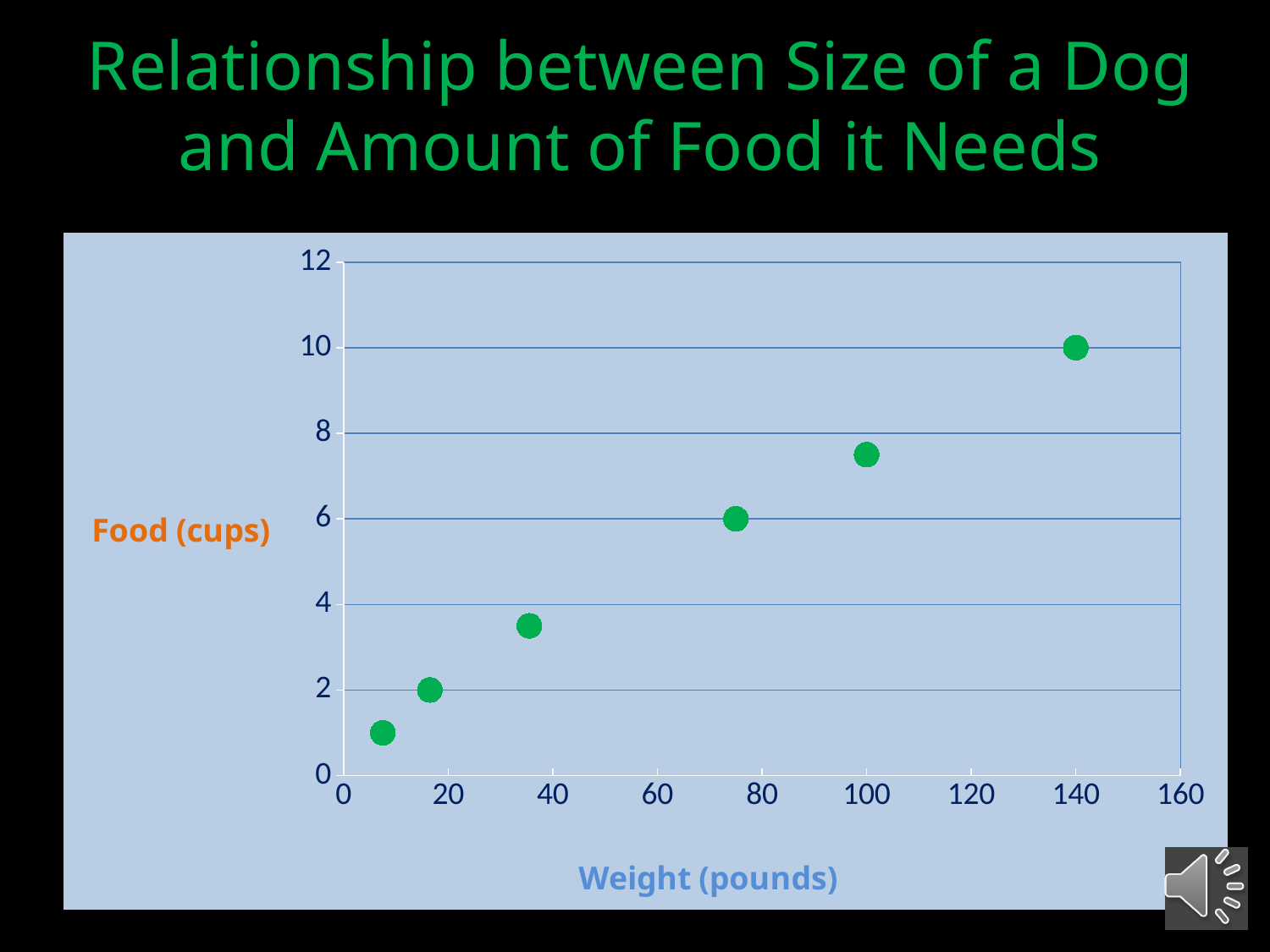
What is the label on the x axis? Weight (pounds) How many cups of food does the point at 140 pounds show? 10 What is the maximum value shown on the y axis? 12 Is the food value for the dog weighing 100 pounds greater or less than 6 cups? greater Is the food value for the point between 20 and 40 pounds greater or less than 4 cups? less What kind of chart is shown on the slide? scatter chart Is the food value for the dog weighing 100 pounds greater or less than 8 cups? less How many data points are plotted on the chart? 6 What is the label on the y axis? Food (cups) Which point has the highest food value: the one at 140 pounds or the one at 100 pounds? the one at 140 pounds Do the food values rise or fall as weight increases along the x axis? rise